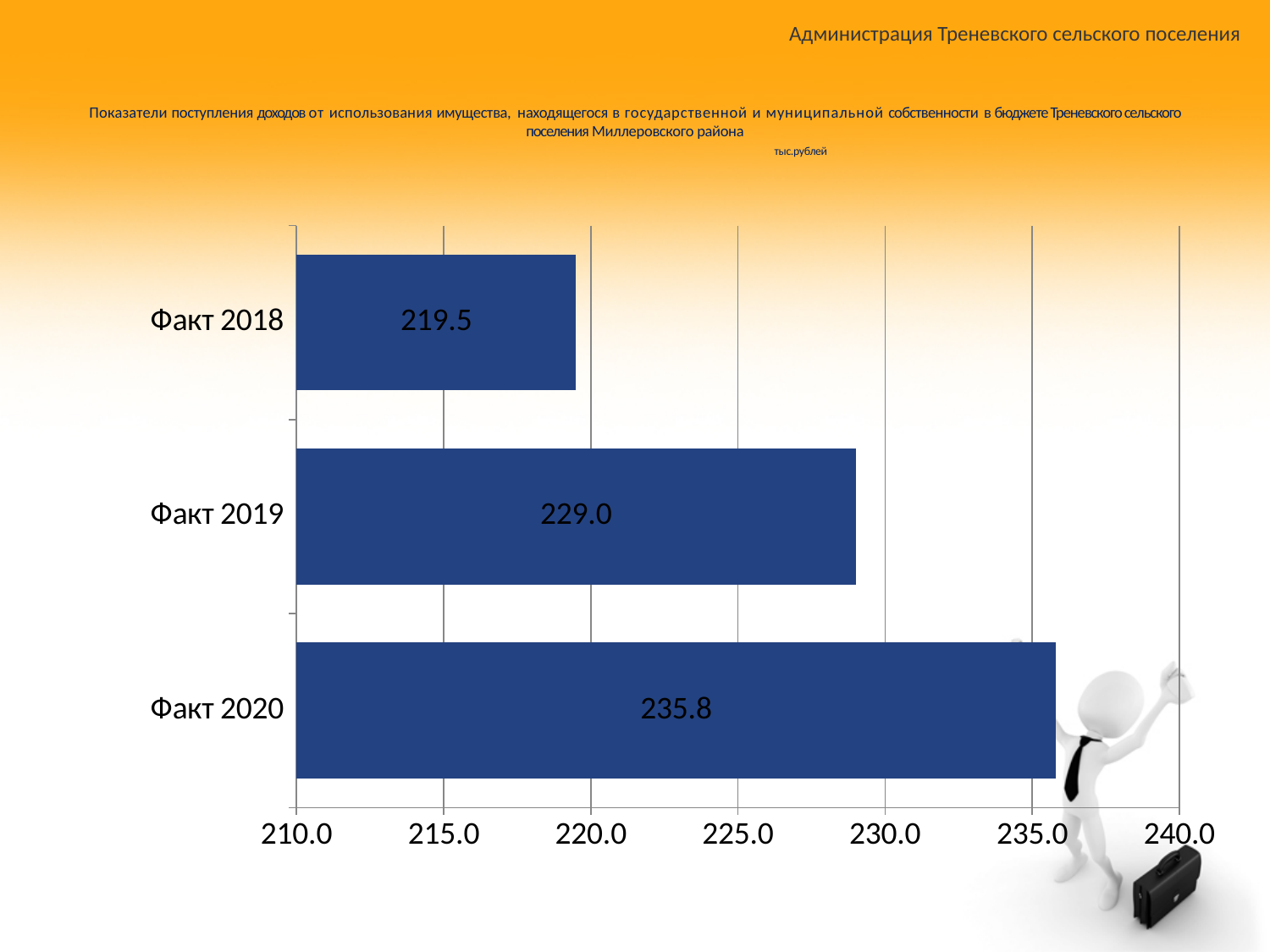
Which category has the highest value? Факт 2020 What is the difference between the values for Факт 2019 and Факт 2018? 9.5 What unit of measurement is stated under the chart title? тыс.рублей Which category has the lowest value? Факт 2018 What is the value for Факт 2019? 229.0 What is the difference between the values for Факт 2020 and Факт 2018? 16.3 What is the value for Факт 2018? 219.5 Which is larger, the value for Факт 2019 or the value for Факт 2020? Факт 2020 How many categories are shown in the chart? 3 Is the value for Факт 2019 greater or less than 225.0? greater What kind of chart is shown on the slide? bar chart What is the value for Факт 2020? 235.8